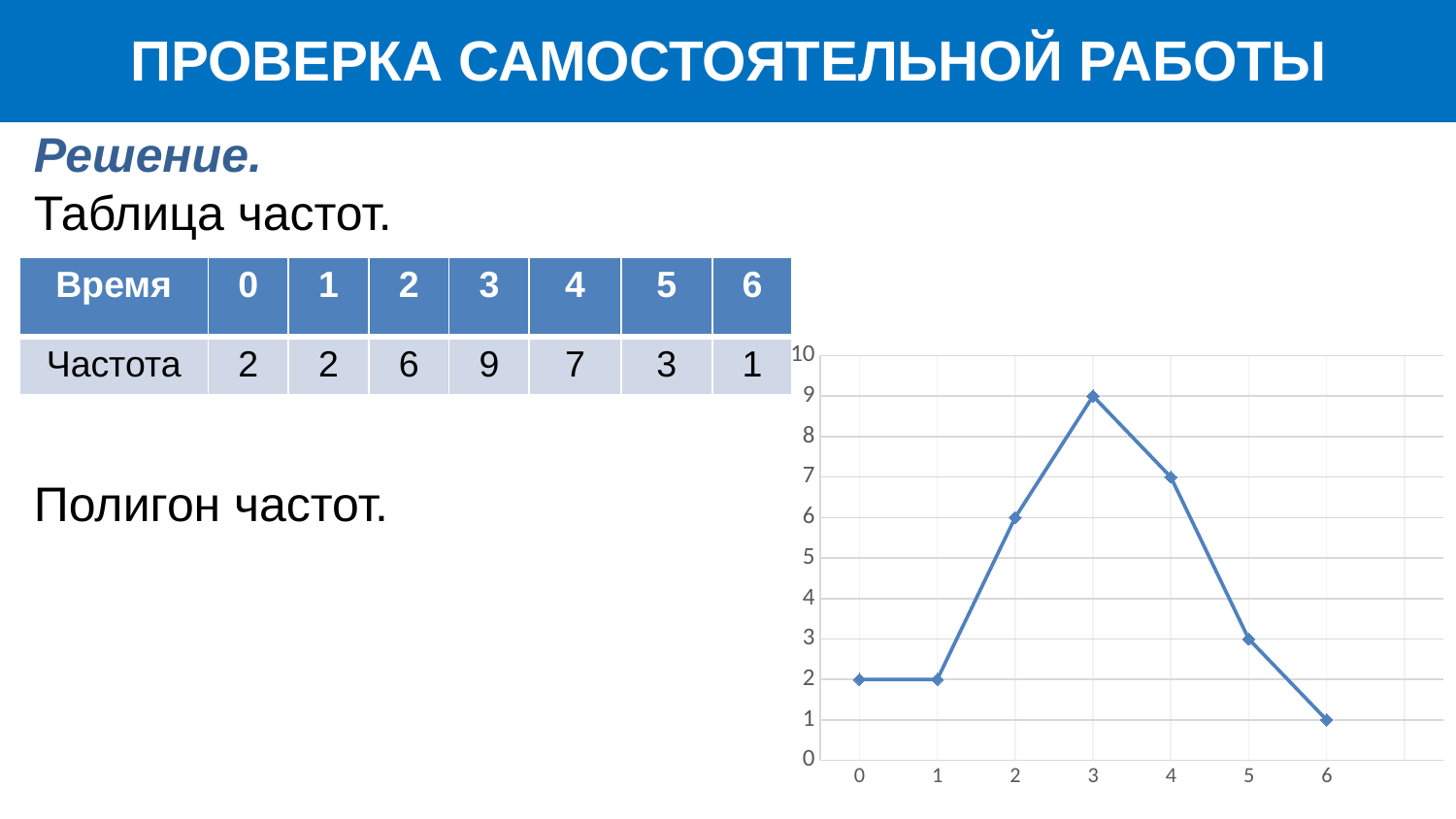
Does the line rise or fall between x = 3 and x = 6? fall What is the maximum value shown on the vertical axis? 10 What is the frequency value plotted at x = 3? 9 Is the value at x = 4 greater or less than 5? greater At which x value does the line reach its highest point? 3 How many data points are plotted on the line? 7 What is the difference between the values at x = 3 and x = 4? 2 Which is larger, the value at x = 2 or the value at x = 5? x = 2 What is the frequency value plotted at x = 2? 6 What is the frequency value plotted at x = 6? 1 At which x value does the line reach its lowest point? 6 What type of chart is shown on the slide? line chart